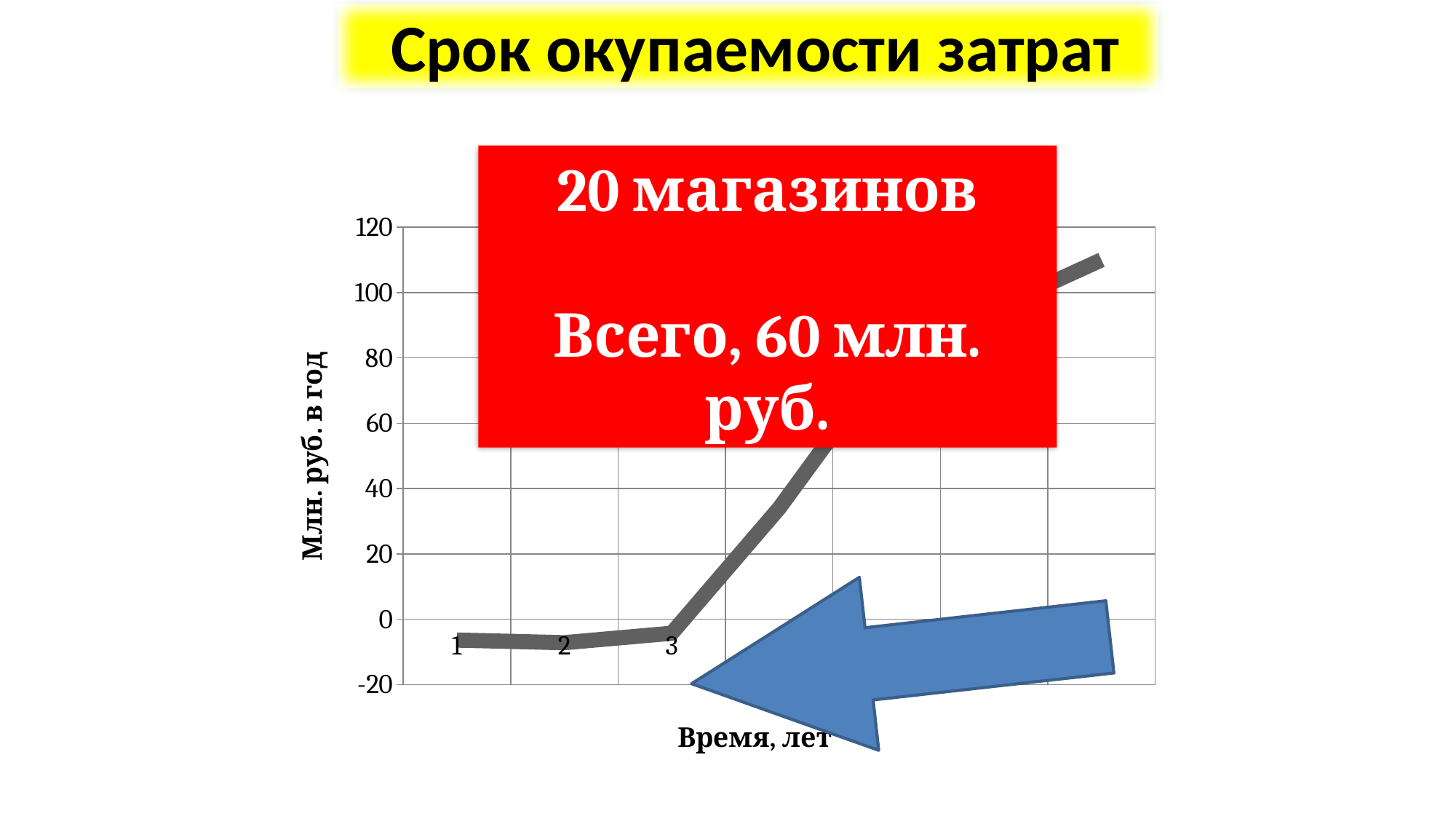
Is the value for year 1 greater or less than 0? less Is the value for year 1 greater or less than -20? greater What is the title of the x axis of the chart? Время, лет Is the value for year 2 greater or less than 0? less What is the title of the y axis of the chart? Млн. руб. в год Overall, do the values rise or fall along the x axis? rise Does the line rise or fall after year 3? rises What kind of chart is shown on the slide? line chart